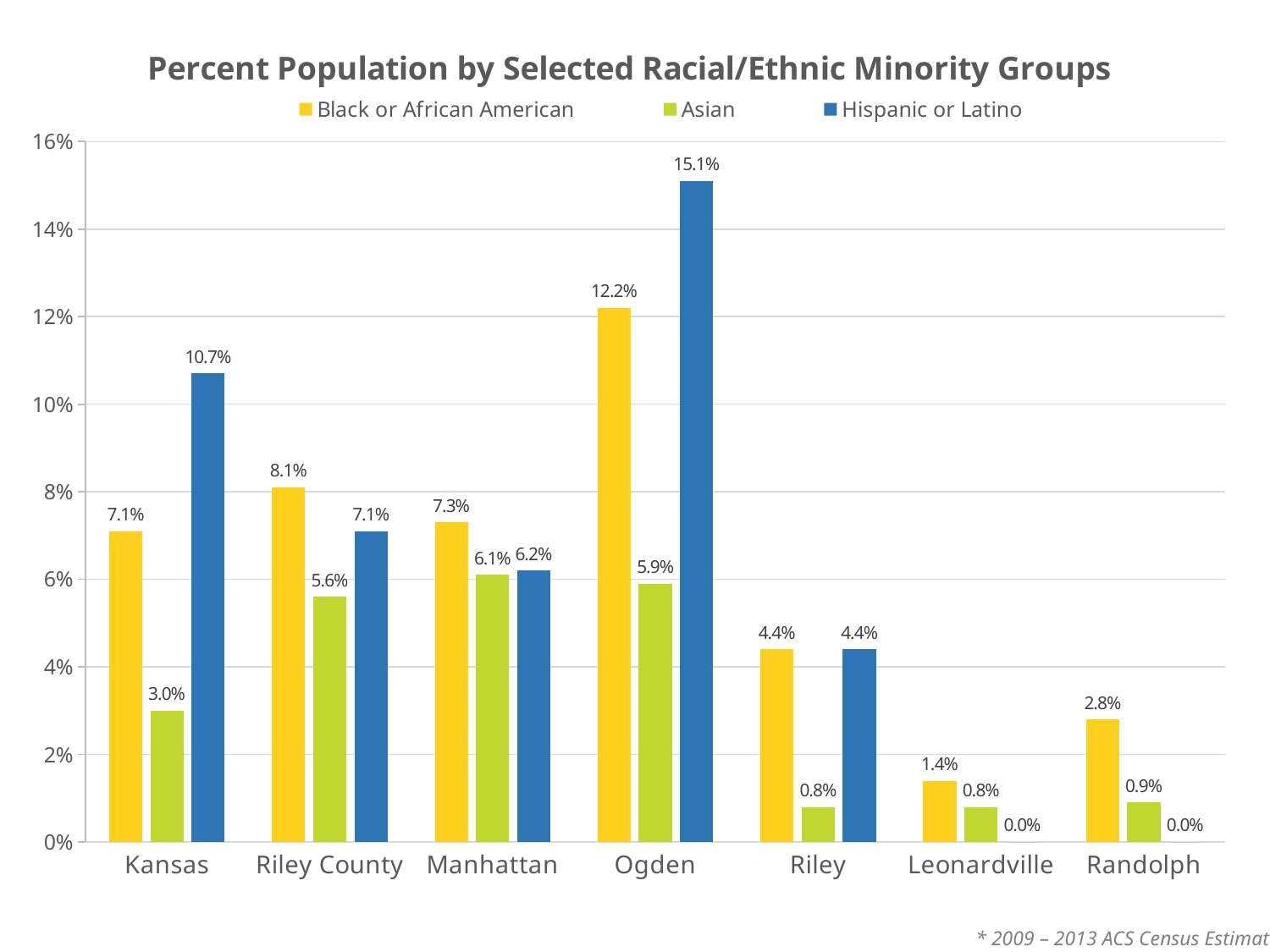
What is the Black or African American percentage for Leonardville? 1.4% What is the title of the chart? Percent Population by Selected Racial/Ethnic Minority Groups What kind of chart is shown on the slide? Bar chart Which category has the highest Hispanic or Latino percentage? Ogden Which is larger for Manhattan: the Black or African American percentage or the Asian percentage? Black or African American Is the Black or African American value for Ogden greater or less than 10%? greater How many categories are shown on the x axis? 7 What is the difference between the Hispanic or Latino and Black or African American percentages for Kansas? 3.6% Which category has the lowest Black or African American percentage? Leonardville What is the Asian percentage for Riley County? 5.6% What is the Hispanic or Latino percentage for Ogden? 15.1% How many series does the legend list? 3